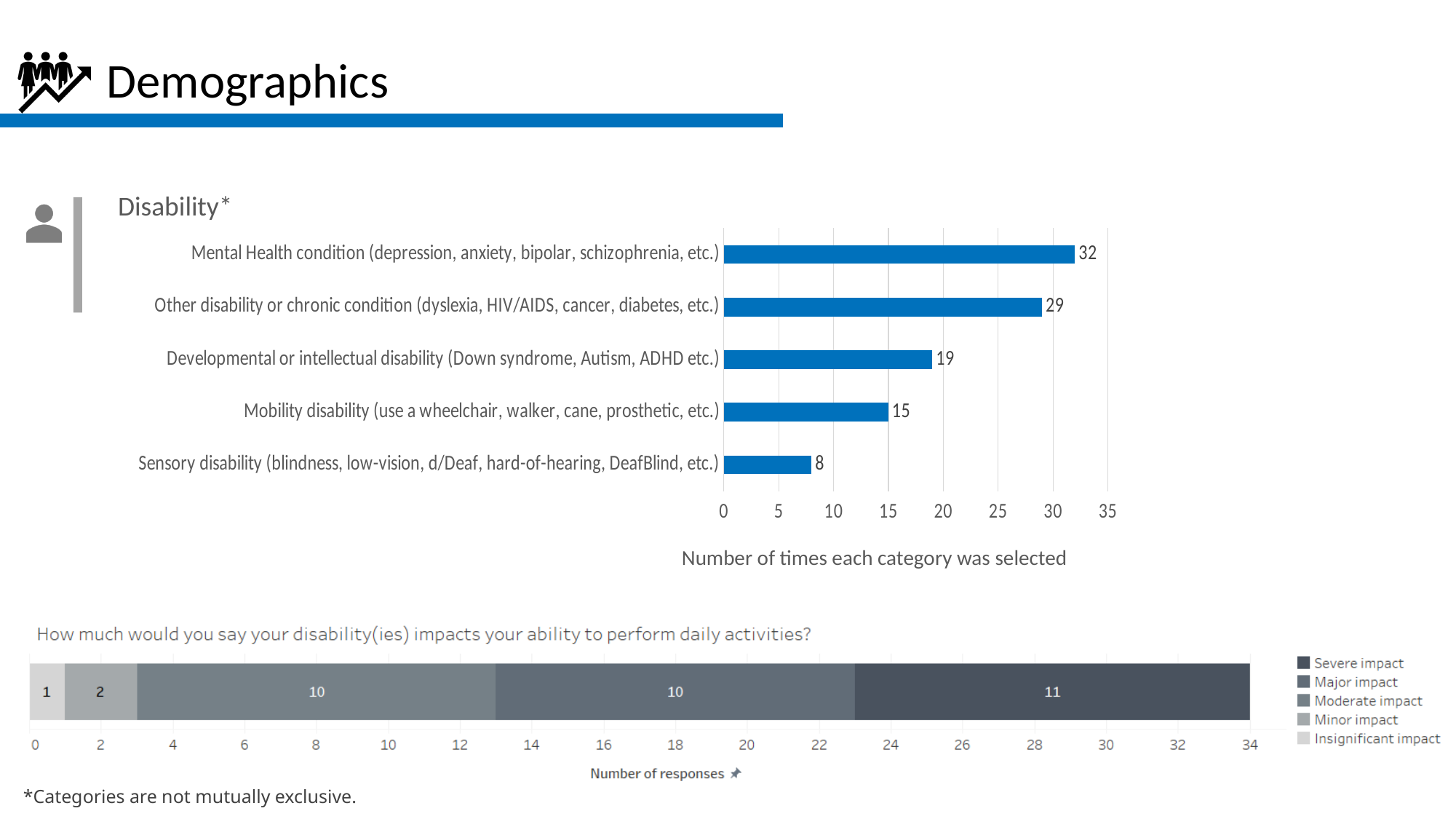
How many series does the legend of the daily activities impact chart list? 5 In the Disability chart, how many times was Mental Health condition selected? 32 In the Disability chart, which category was selected the fewest times? Sensory disability What type of chart is the Disability chart? Bar chart How many categories are shown in the Disability chart? 5 In the Disability chart, which category was selected the most times? Mental Health condition In the daily activities impact chart, how many responses were for Severe impact? 11 In the daily activities impact chart, what is the total number of responses across all segments? 34 In the Disability chart, what is the difference between Other disability or chronic condition and Developmental or intellectual disability? 10 In the Disability chart, what is the value for Sensory disability? 8 In the daily activities impact chart, how many responses were for Minor impact? 2 In the Disability chart, which is larger: Mobility disability or Developmental or intellectual disability? Developmental or intellectual disability